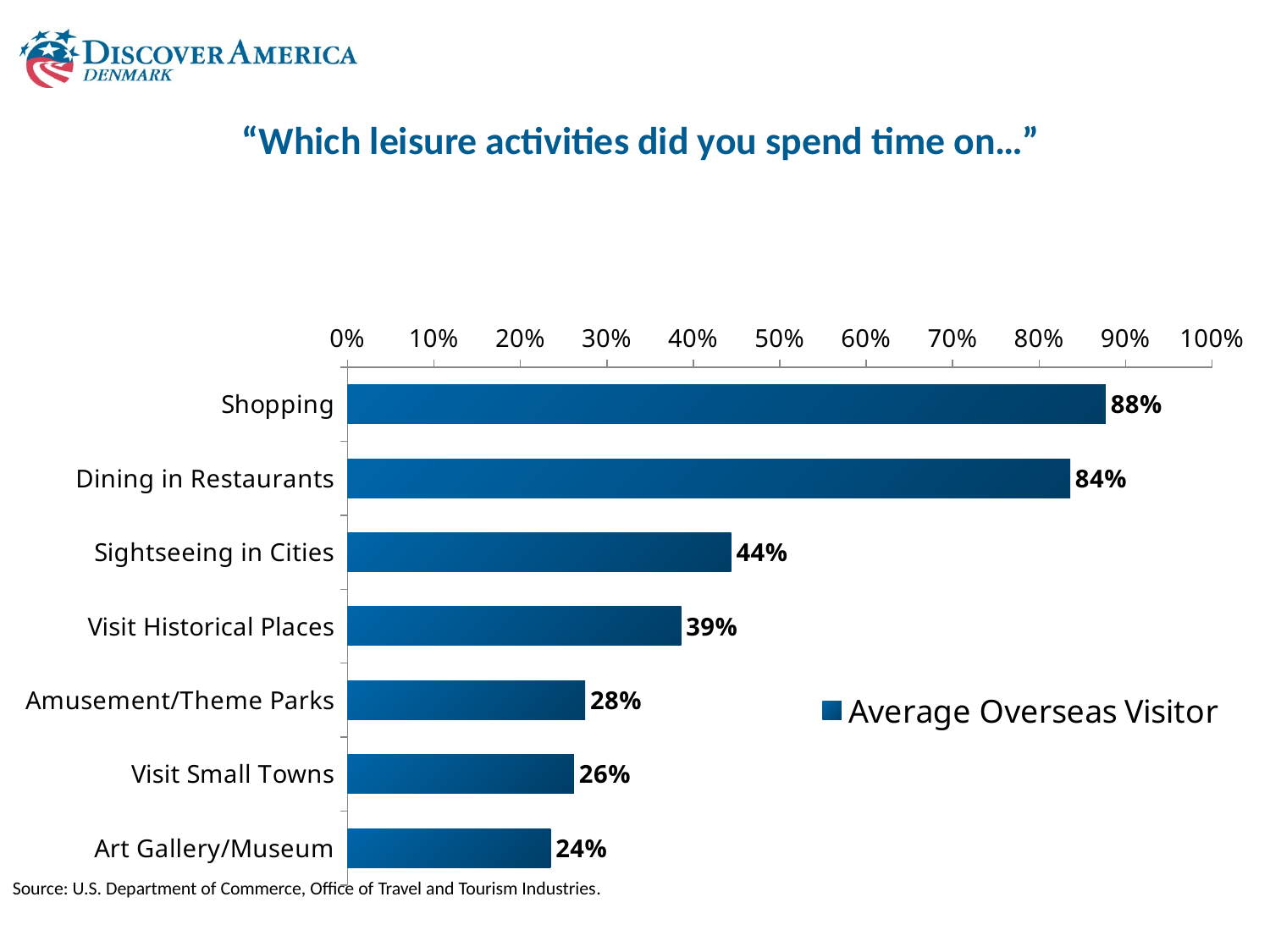
Which leisure activity has the highest value? Shopping How many leisure activities are shown in the chart? 7 What is the difference between the values for Shopping and Dining in Restaurants? 4% What kind of chart is shown on the slide? bar chart Which leisure activity has the lowest value? Art Gallery/Museum How many series does the legend list? 1 Is the value for Sightseeing in Cities greater or less than 50%? less Which is larger, the value for Amusement/Theme Parks or the value for Visit Small Towns? Amusement/Theme Parks What is the value for Visit Historical Places? 39% What percentage of average overseas visitors spent time on Shopping? 88% What is the value for Art Gallery/Museum? 24% What is the difference between the values for Sightseeing in Cities and Visit Small Towns? 18%